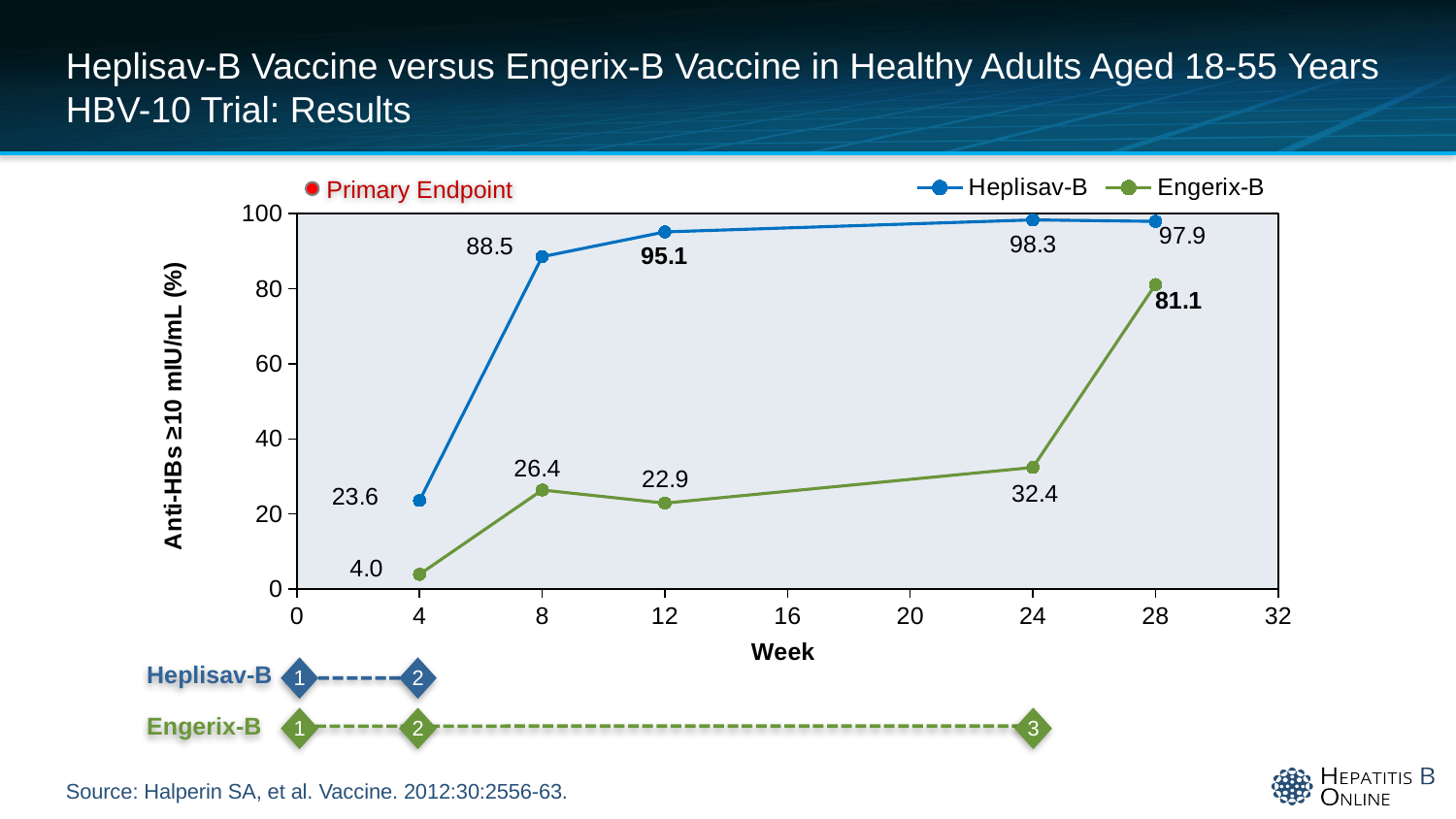
What is the Heplisav-B value at week 8? 88.5 Which series has the larger value at week 28, Heplisav-B or Engerix-B? Heplisav-B What kind of chart is shown on the slide? Line chart What is the Heplisav-B value at week 24? 98.3 What is the difference between the Heplisav-B and Engerix-B values at week 12? 72.2 How many series does the legend list? 2 What is the Engerix-B value at week 28? 81.1 At which week is the Engerix-B value lowest? 4 Does the Engerix-B series rise or fall between week 24 and week 28? Rise What is the Engerix-B value at week 4? 4.0 What is the label of the y axis? Anti-HBs ≥10 mIU/mL (%) At which week is the Heplisav-B value highest? 24